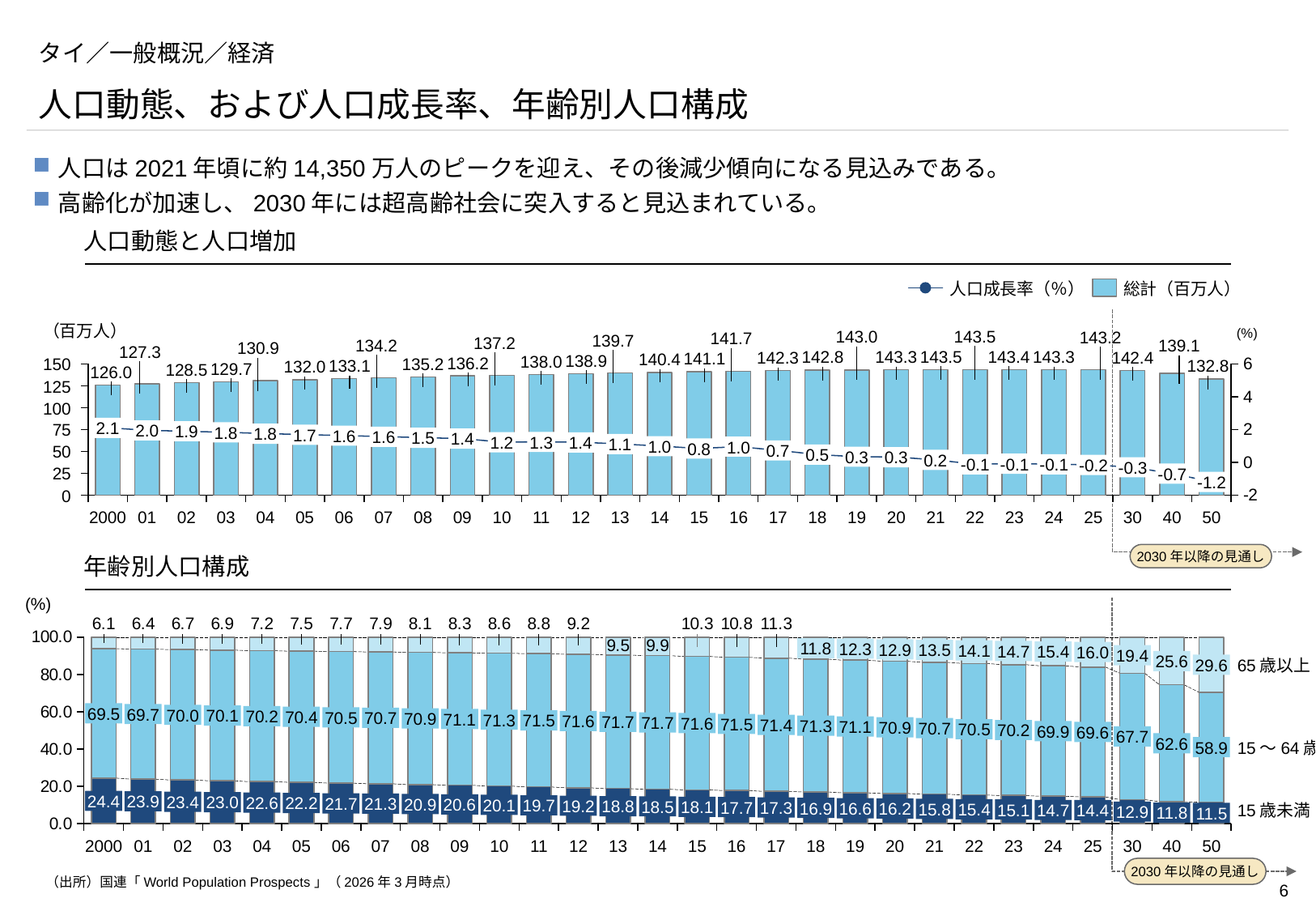
「年齢別人口構成」のグラフはどの種類のグラフですか。 積み上げ棒グラフ 「人口動態と人口増加」のグラフで、総計（百万人）が最も小さい年はどれですか。 2000 「人口動態と人口増加」のグラフで、人口成長率（%）は2000年から2050年にかけて上昇していますか、下降していますか。 下降 「人口動態と人口増加」のグラフで、2025年と2050年の総計（百万人）の差はいくらですか。 10.4 「年齢別人口構成」のグラフで、2030年の15〜64歳と2050年の15〜64歳では、どちらの割合が大きいですか。 2030年 「人口動態と人口増加」のグラフで、凡例にはいくつの系列がありますか。 2 「年齢別人口構成」のグラフで、2025年の65歳以上と15歳未満の割合の差はいくらですか。 1.6 「人口動態と人口増加」のグラフで、2000年の総計（百万人）はいくらですか。 126.0 「人口動態と人口増加」のグラフで、2050年の人口成長率（%）はいくらですか。 -1.2 「年齢別人口構成」のグラフで、2050年の65歳以上の割合はいくらですか。 29.6 「年齢別人口構成」のグラフで、2000年の15歳未満の割合はいくらですか。 24.4 「人口動態と人口増加」のグラフで、総計（百万人）が最も大きい値はいくらですか。 143.5